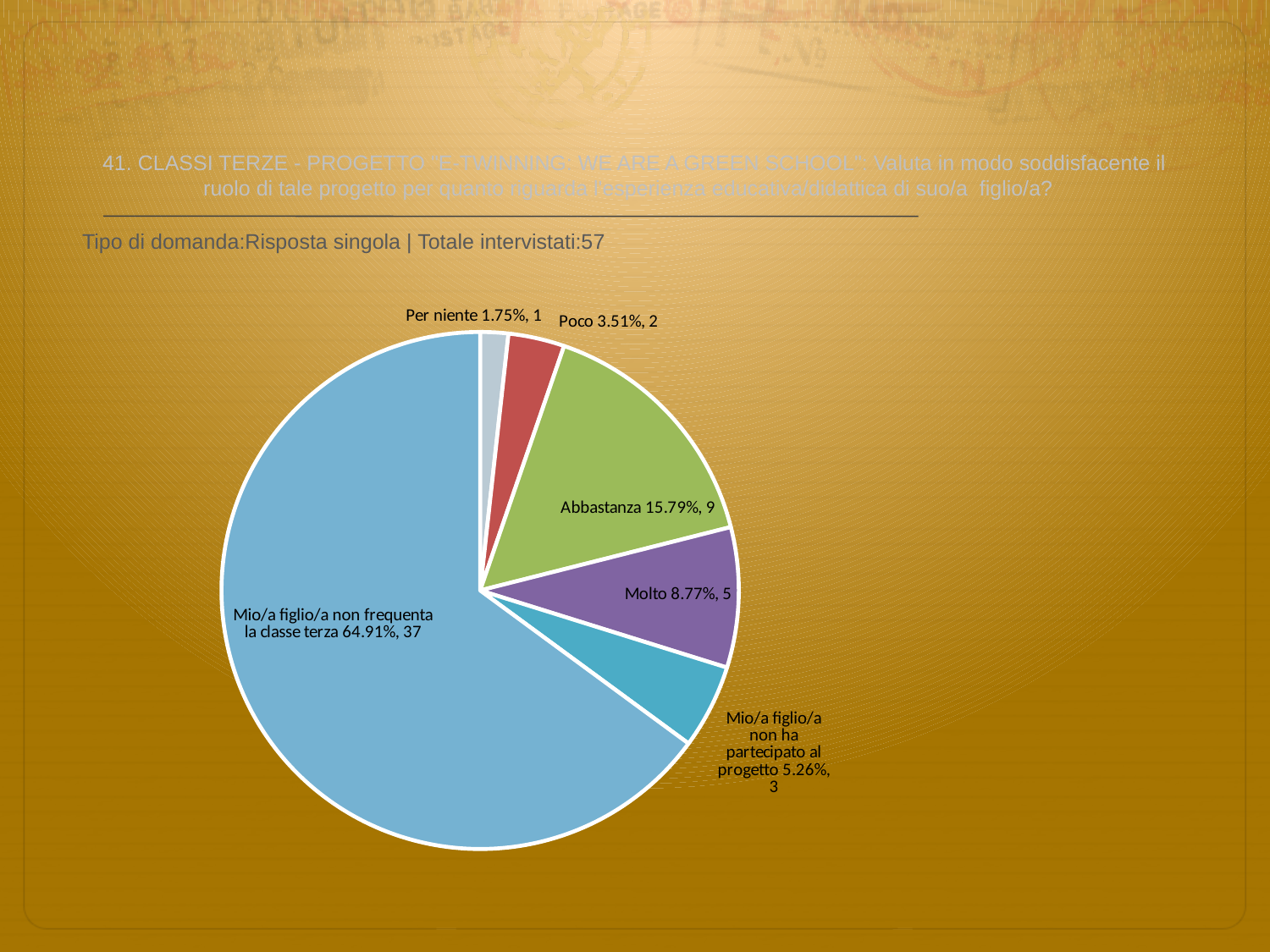
What kind of chart is shown on the slide? pie chart How many respondents answered 'Poco'? 2 What is the difference in count between 'Abbastanza' and 'Molto'? 4 Which category has the largest slice? Mio/a figlio/a non frequenta la classe terza What is the total number of respondents stated on the slide? 57 What percentage share does the 'Mio/a figlio/a non frequenta la classe terza' slice have? 64.91% What percentage share does the 'Per niente' slice have? 1.75% How many respondents answered 'Molto'? 5 Which is larger, the 'Molto' slice or the 'Mio/a figlio/a non ha partecipato al progetto' slice? Molto How many slices does the pie chart have? 6 Which category has the smallest slice? Per niente What percentage share does the 'Abbastanza' slice have? 15.79%